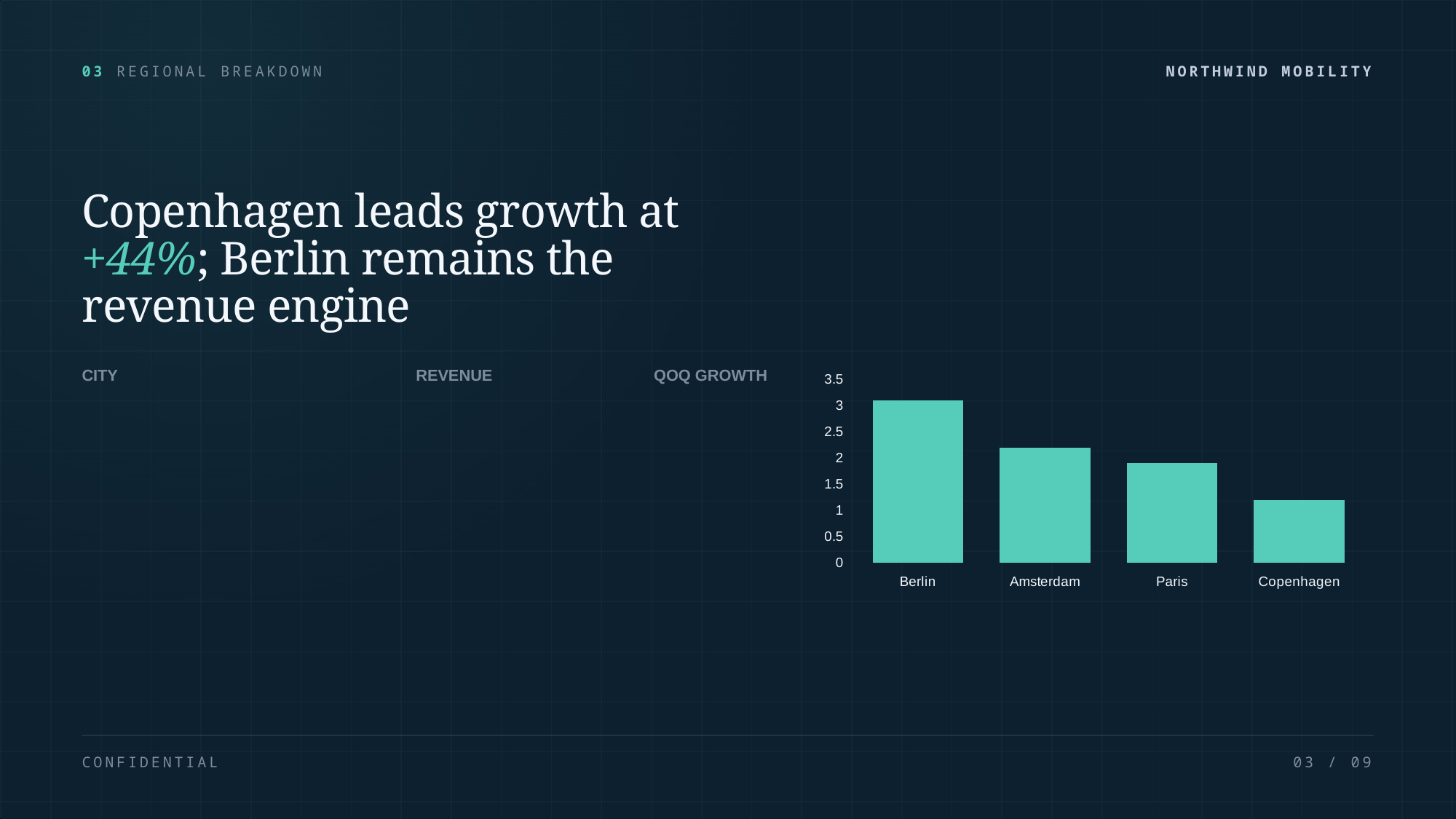
What is the highest value shown on the chart's vertical axis? 3.5 Which city has the shortest bar in the chart? Copenhagen Is the value for Amsterdam greater or less than 2.5? less What kind of chart is shown on the slide? bar chart Do the bar values rise or fall from left to right across the chart? fall Is the value for Paris greater or less than 1.5? greater Is the value for Copenhagen greater or less than 1.5? less Which bar is taller, Copenhagen or Berlin? Berlin How many cities are plotted in the bar chart? 4 Which bar is taller, Amsterdam or Paris? Amsterdam Which city has the tallest bar in the chart? Berlin